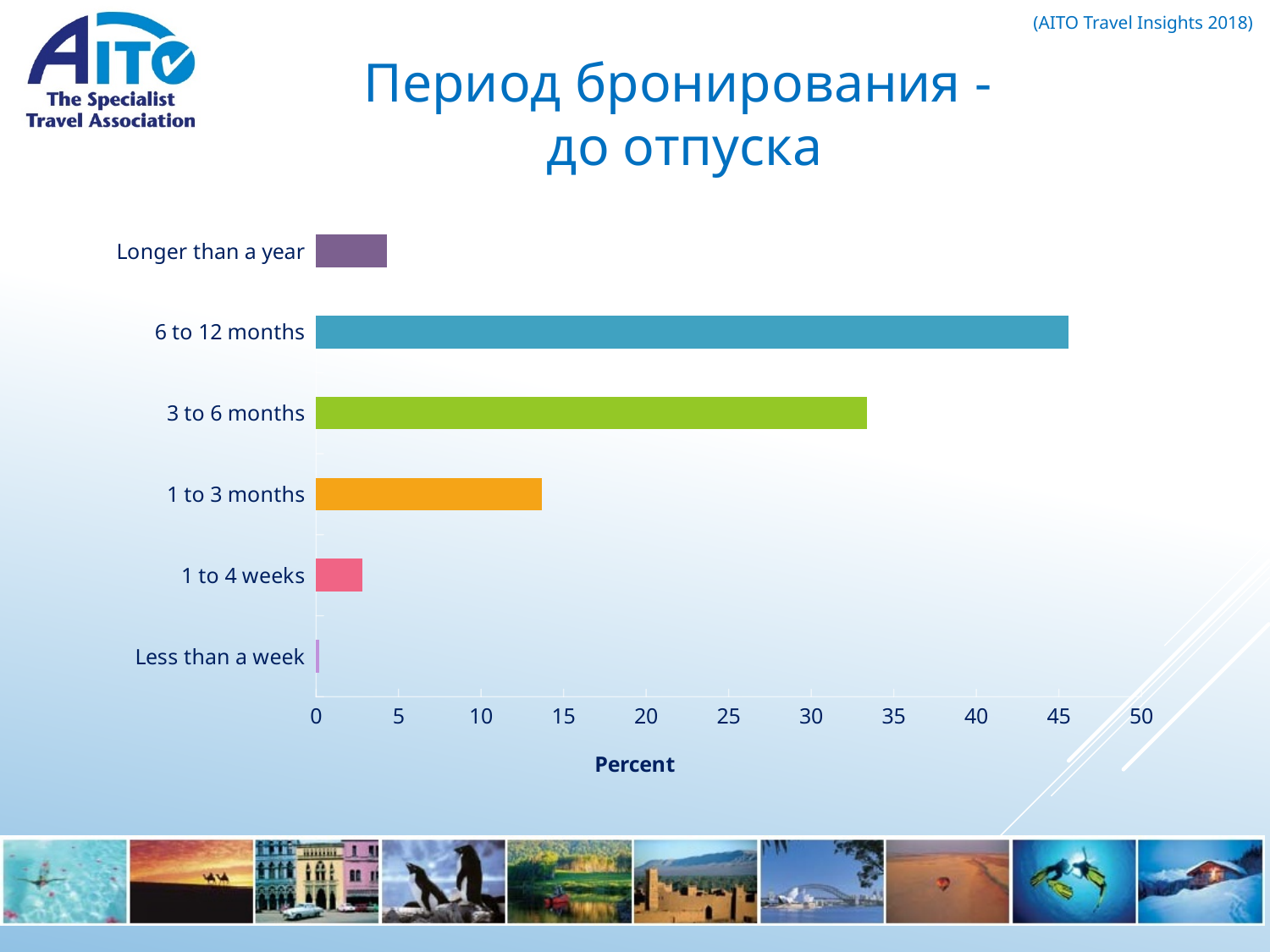
What kind of chart is shown on the slide? bar chart What is the title of the horizontal axis? Percent Is the value for 3 to 6 months greater or less than 30? greater Is the value for 6 to 12 months greater or less than 40? greater Which category has the lowest value? Less than a week Is the value for 1 to 4 weeks greater or less than 5? less Which is larger, the value for Longer than a year or the value for 1 to 4 weeks? Longer than a year How many categories are shown in the chart? 6 Which category has the highest value? 6 to 12 months Which is larger, the value for 3 to 6 months or the value for 1 to 3 months? 3 to 6 months